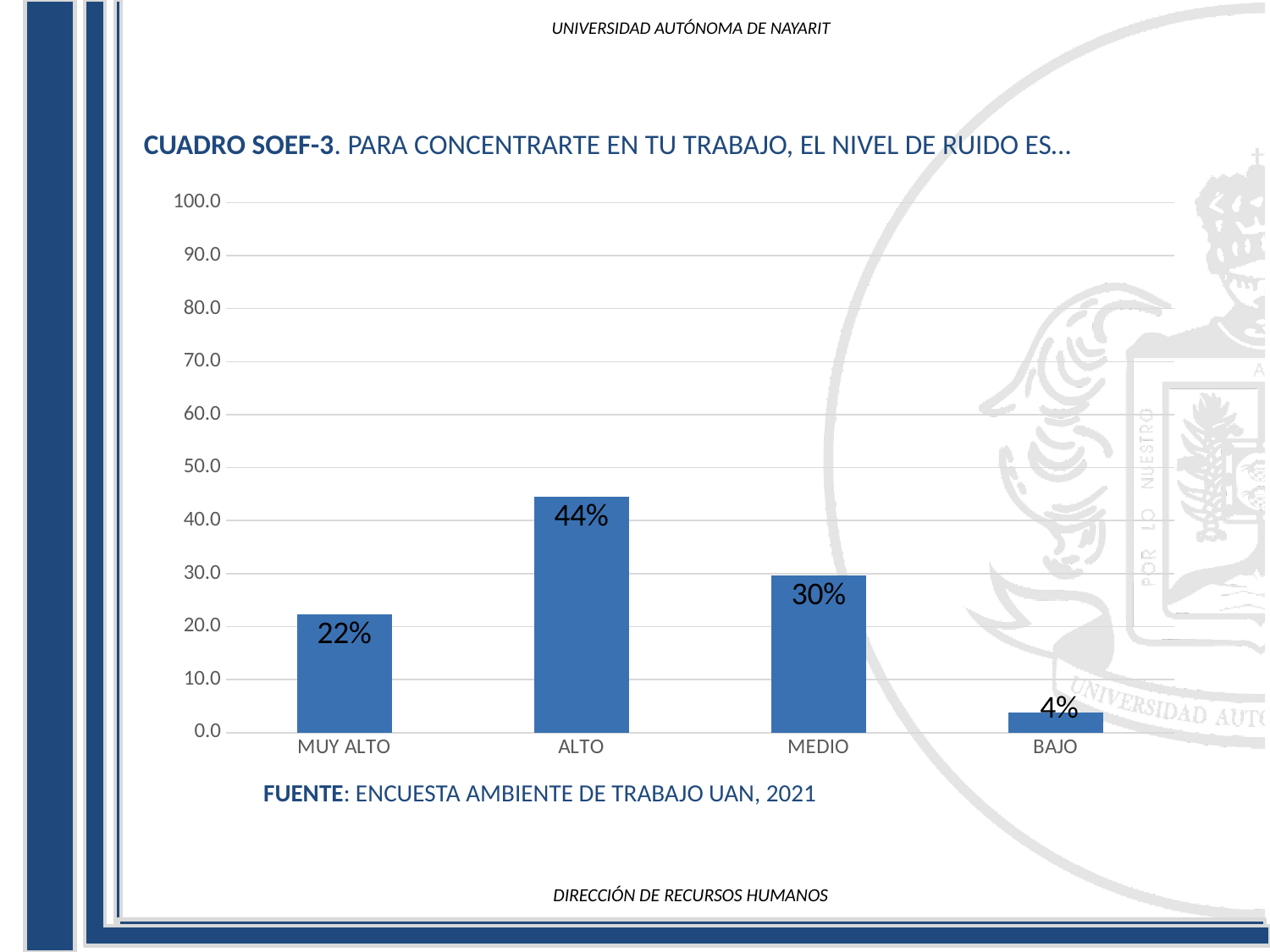
What is the value for MEDIO? 30% What is the value for MUY ALTO? 22% Which category has the lowest value? BAJO Which category has the highest value? ALTO How many categories are shown on the x axis? 4 What is the value for BAJO? 4% What is the difference between the values for ALTO and MEDIO? 14% What kind of chart is shown on the slide? bar chart What is the value for ALTO? 44% Which is larger, the value for MUY ALTO or the value for MEDIO? MEDIO Is the value for ALTO greater or less than 50.0? less What source is cited below the chart? ENCUESTA AMBIENTE DE TRABAJO UAN, 2021